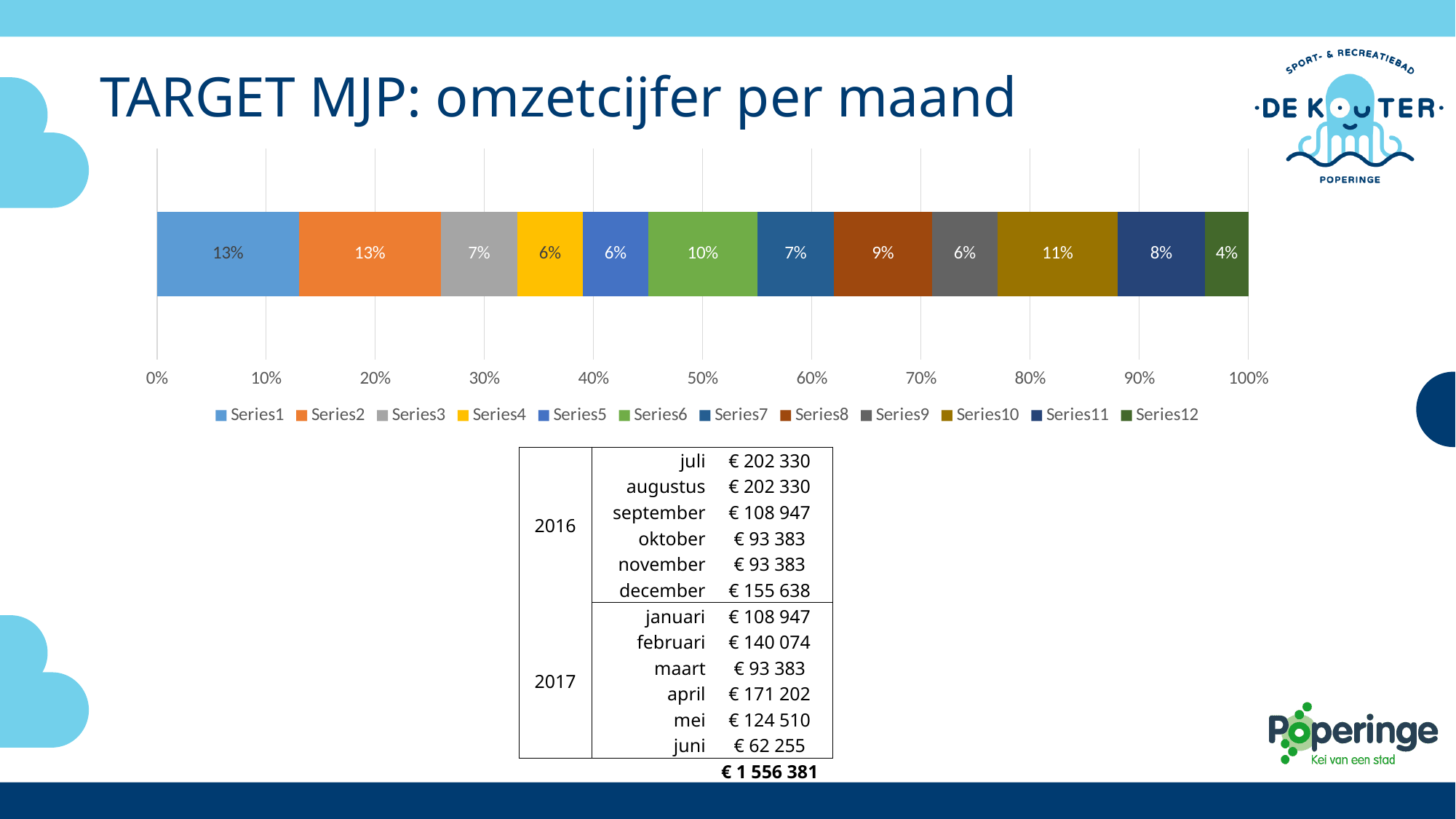
What is the value shown for Series1 in the chart? 13% What is the total of all segments in the stacked bar? 100% What is the value shown for Series11 in the chart? 8% What is the value shown for Series12 in the chart? 4% Which series has the smallest segment in the stacked bar? Series12 What is the value shown for Series6 in the chart? 10% Which is larger, the value for Series6 or the value for Series8? Series6 What is the highest tick value shown on the horizontal axis of the chart? 100% How many series does the chart legend list? 12 What kind of chart is shown on the slide? Stacked bar chart What is the value shown for Series10 in the chart? 11% What is the difference between the values for Series10 and Series12? 7%